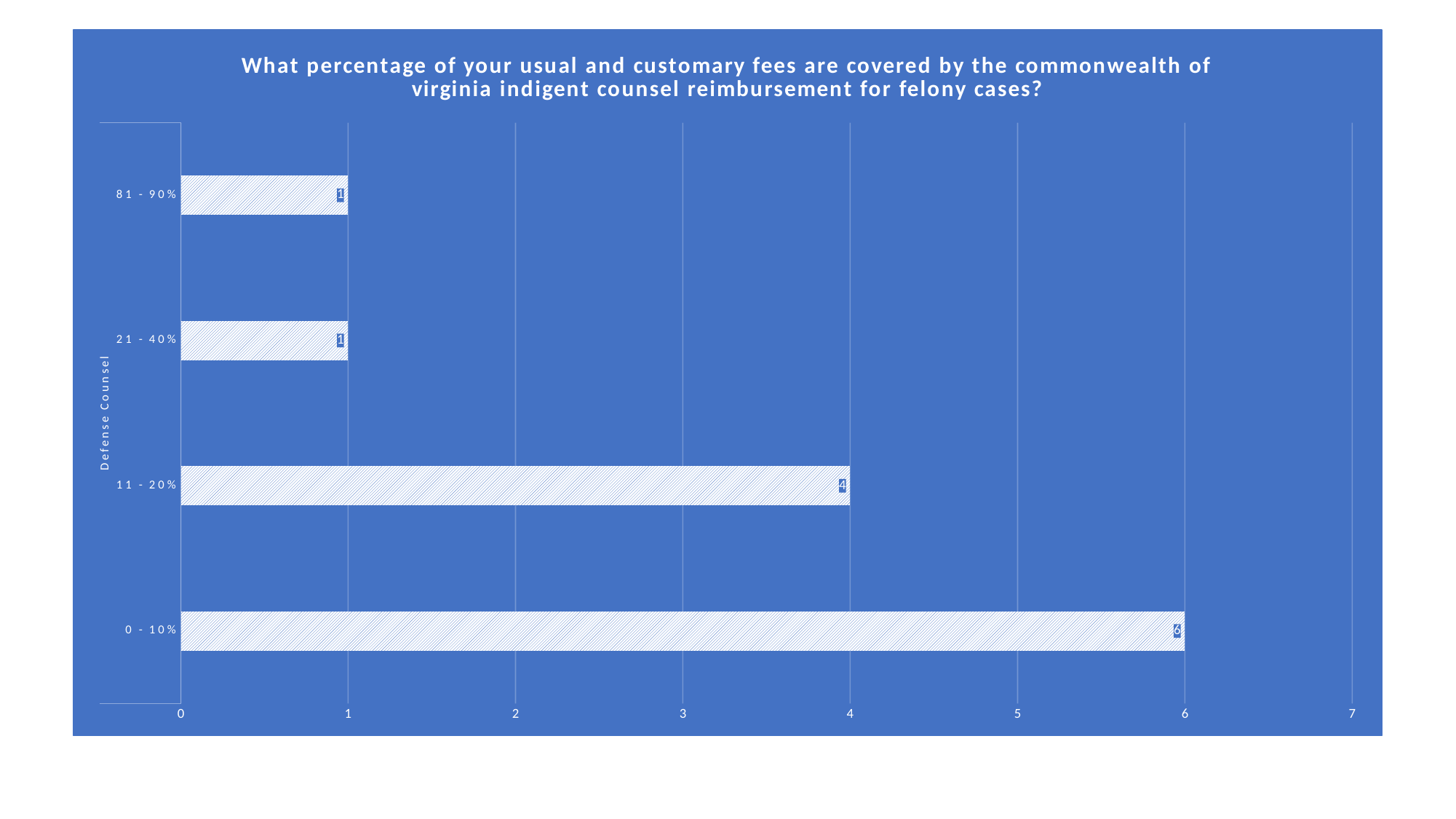
What is the difference between the values for 0 - 10% and 11 - 20%? 2 Which is larger, the value for 11 - 20% or the value for 81 - 90%? 11 - 20% What is the value for the 0 - 10% category? 6 Is the value for 0 - 10% greater or less than 5? greater What is the difference between the values for 11 - 20% and 21 - 40%? 3 What is the value for the 81 - 90% category? 1 Which category has the highest value? 0 - 10% What is the value for the 21 - 40% category? 1 What kind of chart is shown on the slide? bar chart What is the label of the vertical axis? Defense Counsel What is the value for the 11 - 20% category? 4 How many categories are shown on the chart? 4